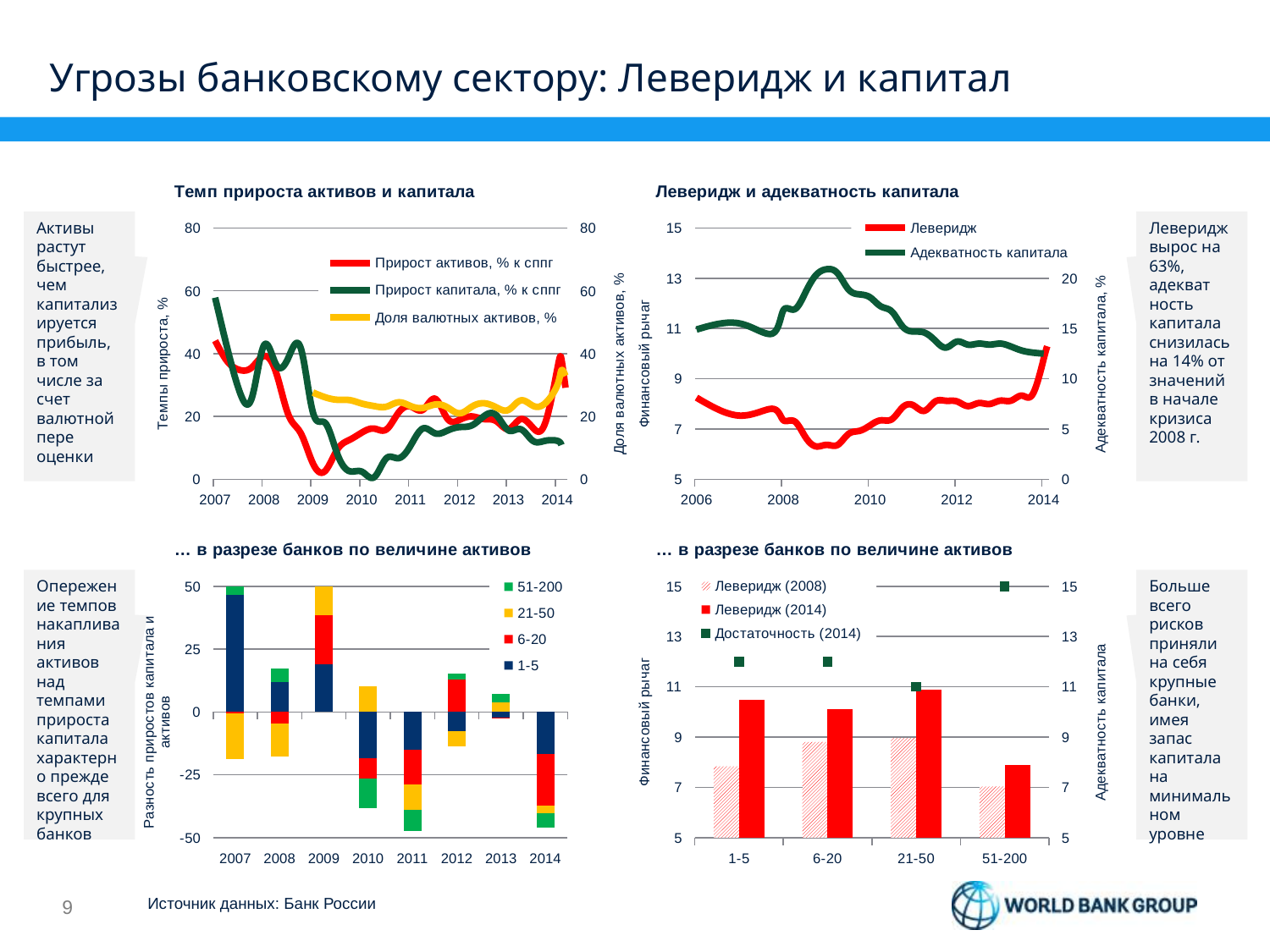
In the chart titled "Леверидж и адекватность капитала", how many series does the legend list? 2 In the bottom-right chart ("… в разрезе банков по величине активов"), which bank group has the lowest "Леверидж (2014)" value? 51-200 In the chart titled "Леверидж и адекватность капитала", is the "Леверидж" value at the end of 2014 greater or less than 9 on the left axis? greater In the bottom-right chart ("… в разрезе банков по величине активов"), which bank group has the highest "Достаточность (2014)" marker? 51-200 In the chart titled "Темп прироста активов и капитала", is the value of "Прирост капитала, % к сппг" at the start of 2007 greater or less than 40? greater In the bottom-left stacked bar chart ("… в разрезе банков по величине активов"), how many series does the legend list? 4 In the bottom-right chart ("… в разрезе банков по величине активов"), for the 1-5 group, which is larger: "Леверидж (2008)" or "Леверидж (2014)"? Леверидж (2014) In the chart titled "Темп прироста активов и капитала", how many series does the legend list? 3 In the bottom-left chart ("… в разрезе банков по величине активов"), what kind of chart is it? bar chart In the chart titled "Темп прироста активов и капитала", what kind of chart is it? line chart In the chart titled "Леверидж и адекватность капитала", does the "Адекватность капитала" line rise or fall between 2009 and 2014? fall In the bottom-left stacked bar chart ("… в разрезе банков по величине активов"), how many years are shown on the x axis? 8